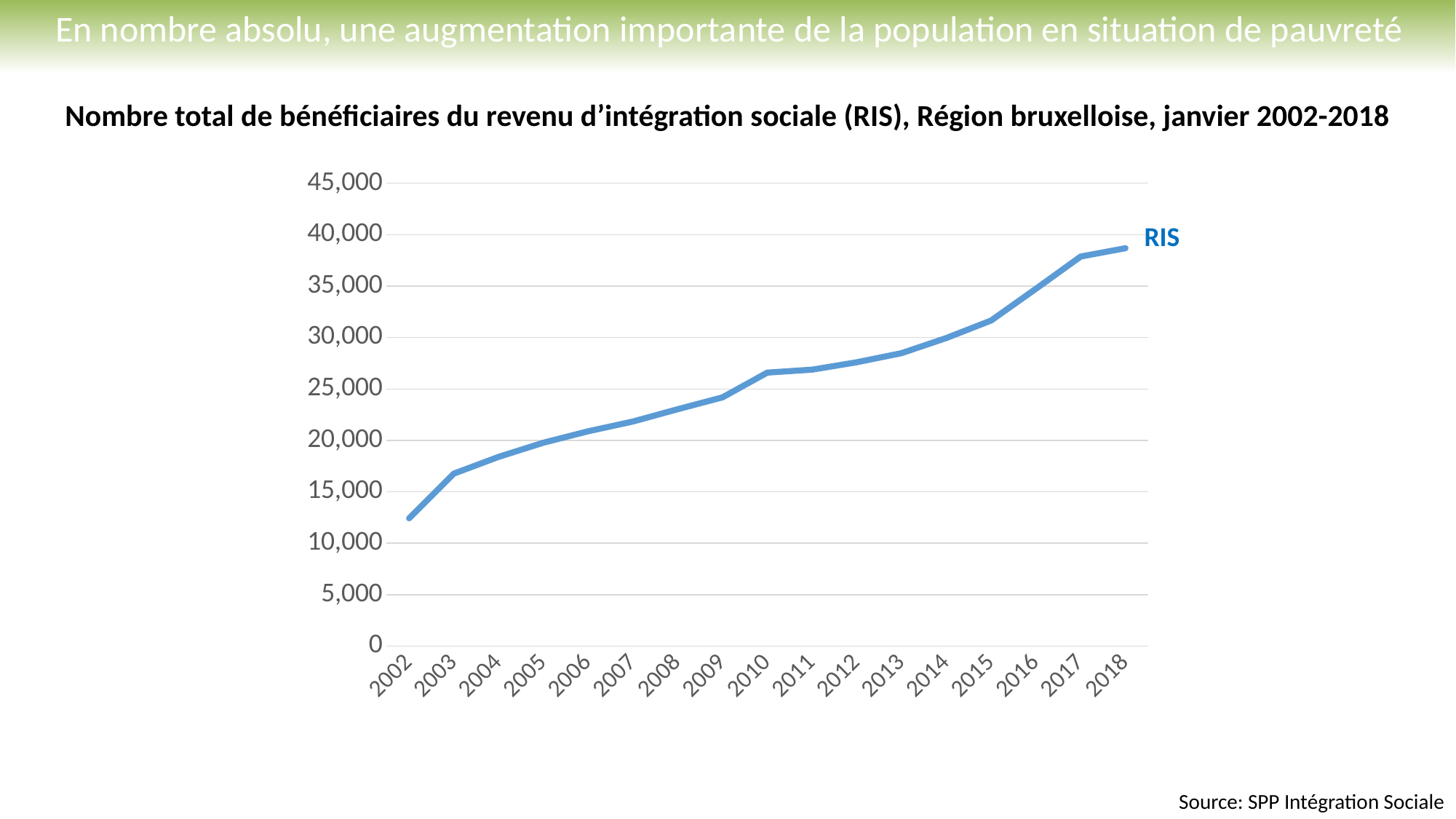
What kind of chart is shown on the slide? line chart Is the value for 2010 greater or less than 25,000? greater Is the value for 2018 greater or less than 35,000? greater How many years are plotted on the x axis of the chart? 17 Which is larger, the value for 2016 or the value for 2010? 2016 Is the value for 2002 greater or less than 15,000? less Which year has the lowest number of RIS beneficiaries? 2002 What label is shown next to the end of the line? RIS Which year has the highest number of RIS beneficiaries? 2018 Do the values rise or fall from 2002 to 2018? rise